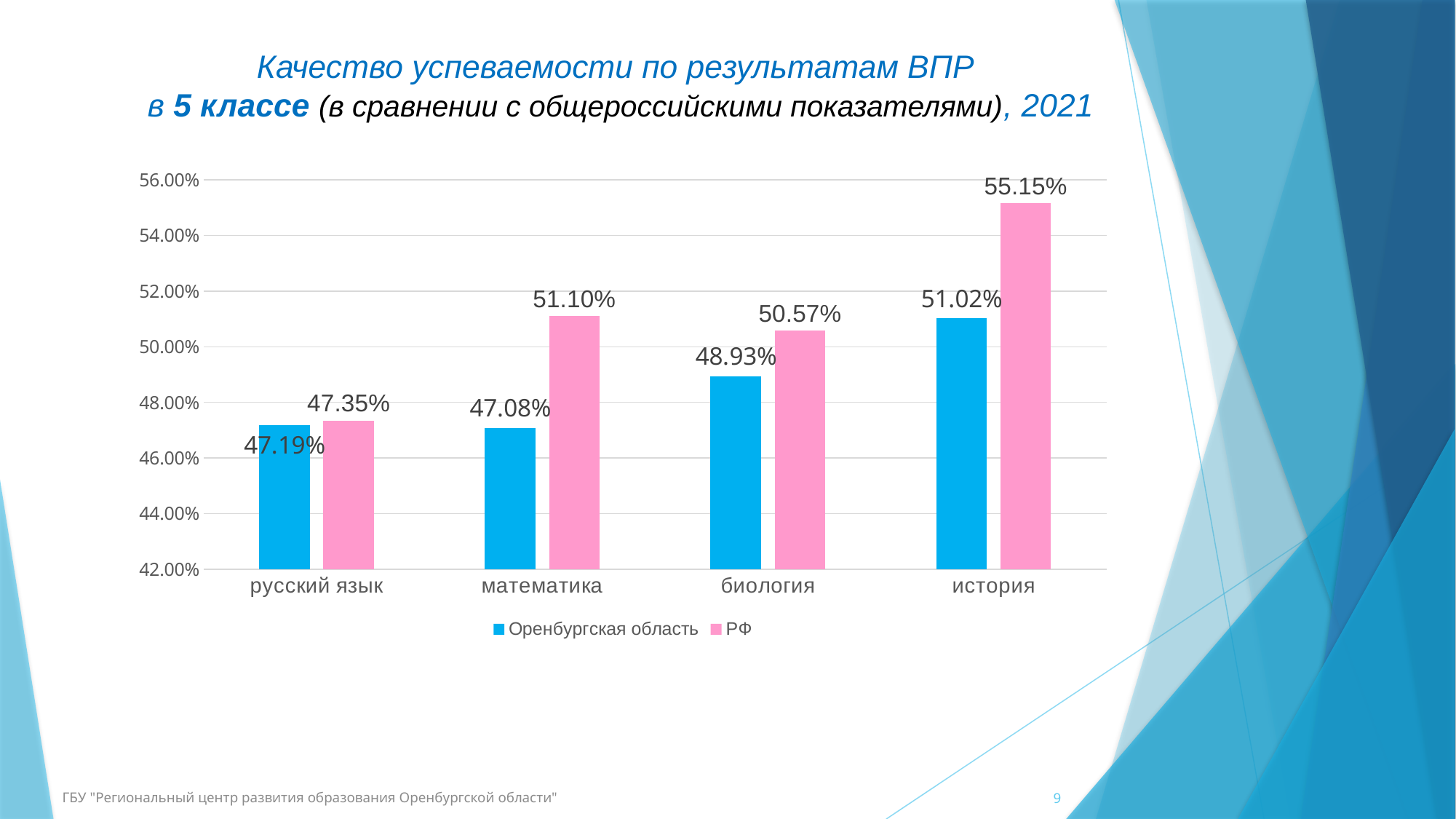
What is the value for Оренбургская область in история? 51.02% What is the value for Оренбургская область in биология? 48.93% What is the difference between the РФ and Оренбургская область values in история? 4.13% In which subject is the Оренбургская область value lowest? математика How many series does the legend list? 2 What is the value for РФ in математика? 51.10% Is the value for РФ in история greater or less than 54.00%? greater Which is larger in биология: the value for Оренбургская область or for РФ? РФ What kind of chart is shown on the slide? bar chart In which subject is the РФ value highest? история What is the value for РФ in русский язык? 47.35% How many subjects are shown on the x axis? 4